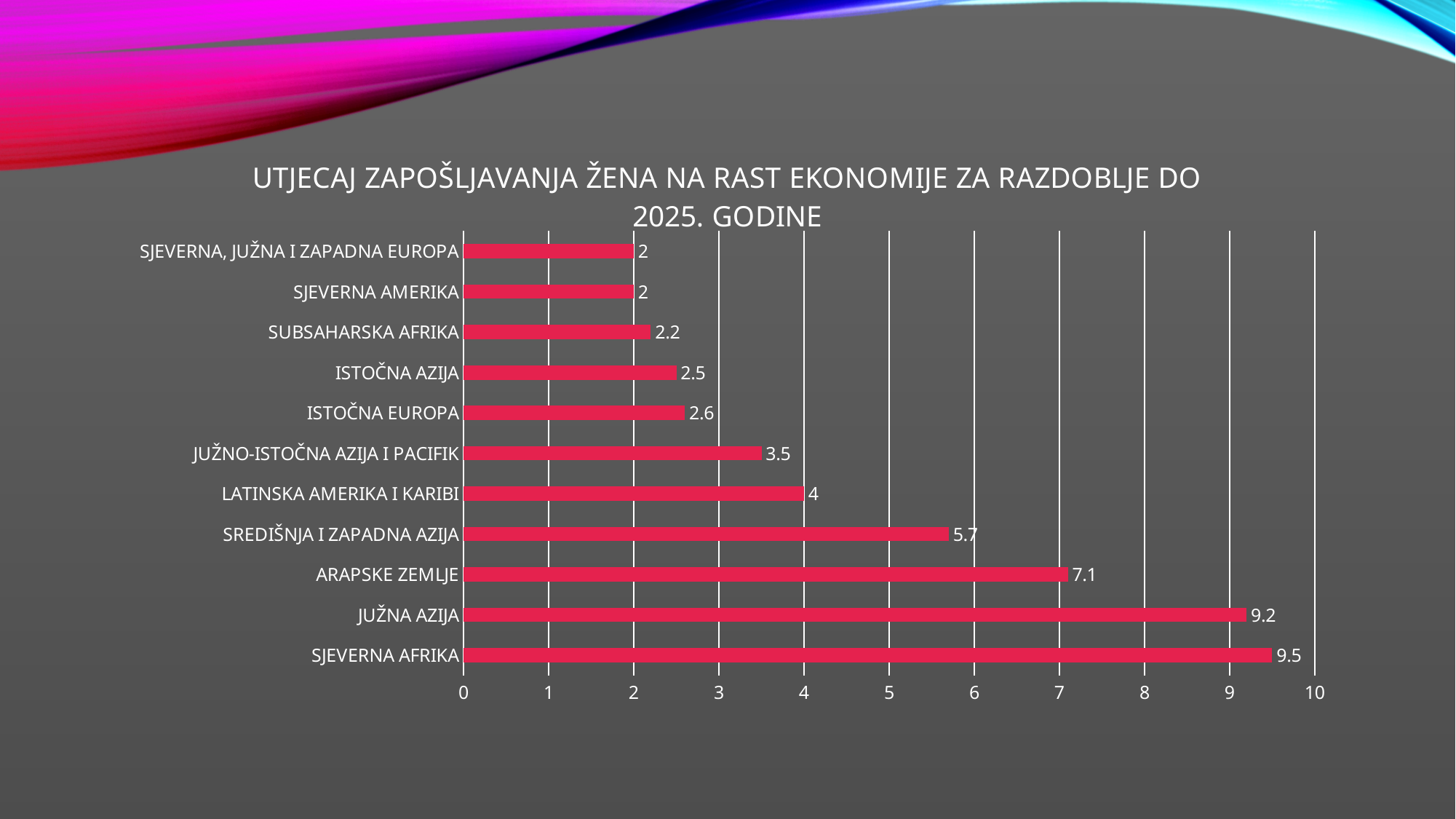
How many categories are shown in the chart? 11 What is the difference between the values for JUŽNA AZIJA and SREDIŠNJA I ZAPADNA AZIJA? 3.5 Which is larger, the value for LATINSKA AMERIKA I KARIBI or the value for ISTOČNA AZIJA? LATINSKA AMERIKA I KARIBI What is the value for SJEVERNA AFRIKA? 9.5 Is the value for ARAPSKE ZEMLJE greater or less than 6? greater What is the value for SUBSAHARSKA AFRIKA? 2.2 What is the maximum value shown on the horizontal axis? 10 What is the difference between the values for SJEVERNA AFRIKA and SJEVERNA AMERIKA? 7.5 What is the value for ISTOČNA EUROPA? 2.6 What kind of chart is shown on the slide? bar chart What is the value for ARAPSKE ZEMLJE? 7.1 Which category has the highest value? SJEVERNA AFRIKA